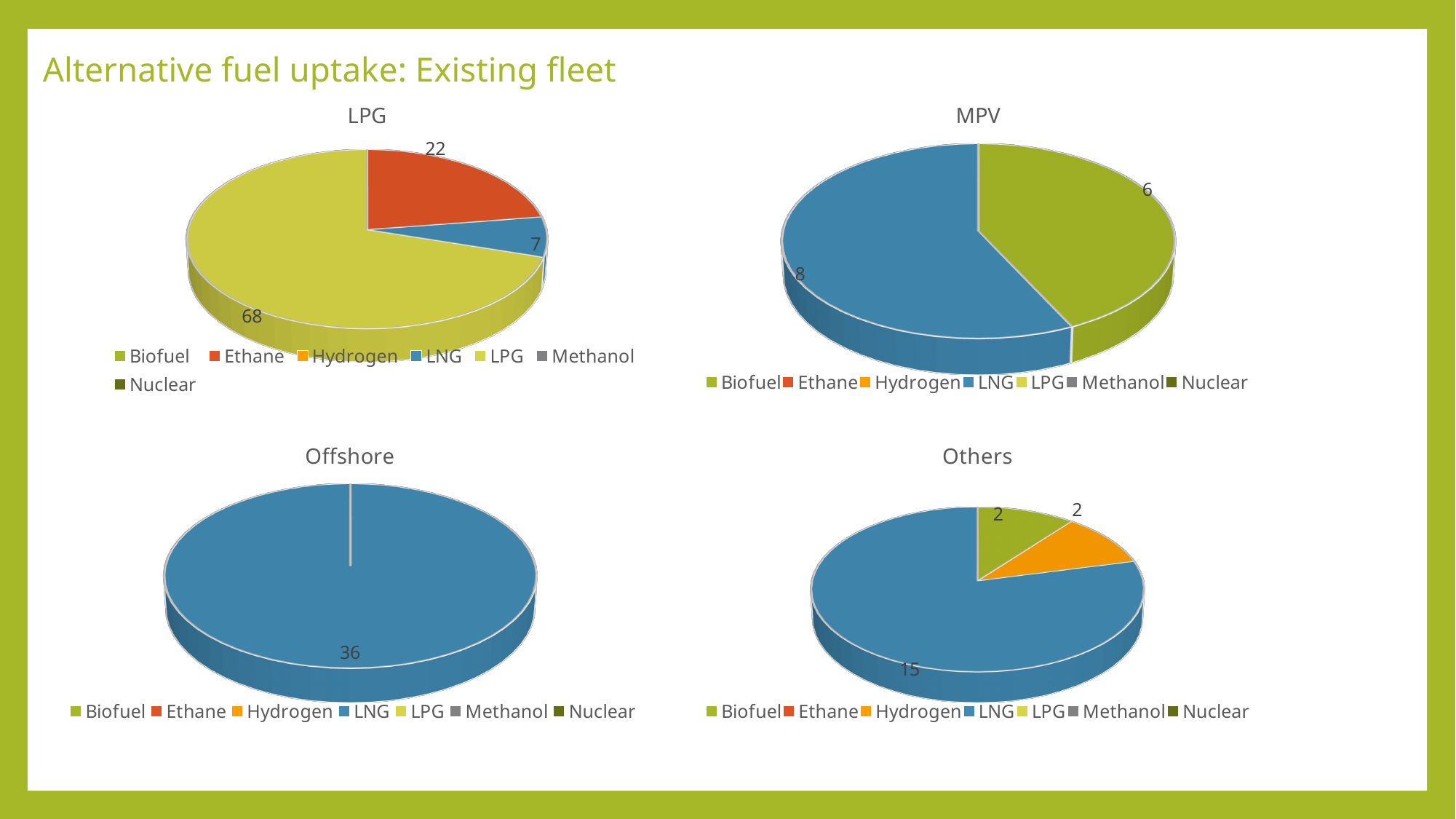
In the MPV chart, what is the value of the LNG slice? 8 In the LPG chart, which fuel has the largest slice? LPG In the MPV chart, which is larger, Biofuel or LNG? LNG How many entries does the legend of the Offshore chart list? 7 In the MPV chart, what is the total of the two slices shown? 14 In the Others chart, how many slices are shown in the pie? 3 What type of chart is the Others chart? Pie chart In the Others chart, what is the value of the LNG slice? 15 In the LPG chart, what is the value of the Ethane slice? 22 In the Offshore chart, what is the value of the LNG slice? 36 In the LPG chart, what is the value of the LPG slice? 68 In the LPG chart, what is the difference between the Ethane and LNG values? 15